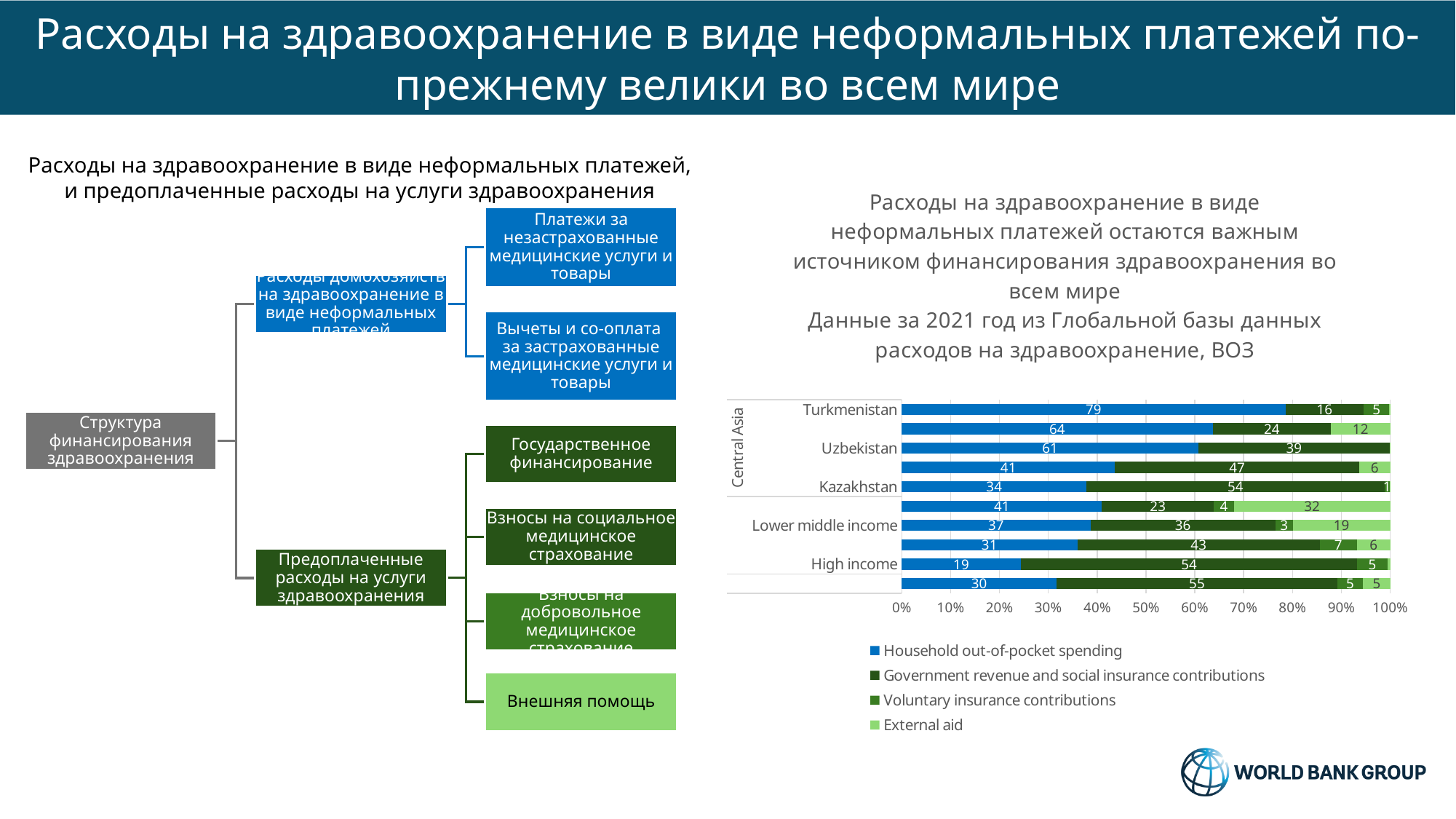
Which has a larger Household out-of-pocket spending value, Turkmenistan or Kazakhstan? Turkmenistan What kind of chart is shown on the slide? Stacked bar chart Which colour represents External aid in the chart legend? Light green What is the Government revenue and social insurance contributions value for Kazakhstan? 54 What is the Government revenue and social insurance contributions value for Uzbekistan? 39 What is the Household out-of-pocket spending value for High income? 19 How many series does the chart legend list? 4 Is the Household out-of-pocket spending value for Kazakhstan greater or less than 50%? less What is the External aid value for Lower middle income? 19 What is the Household out-of-pocket spending value for Turkmenistan? 79 Which labeled category has the highest Household out-of-pocket spending value? Turkmenistan What is the difference between the Household out-of-pocket spending values for Turkmenistan and Uzbekistan? 18